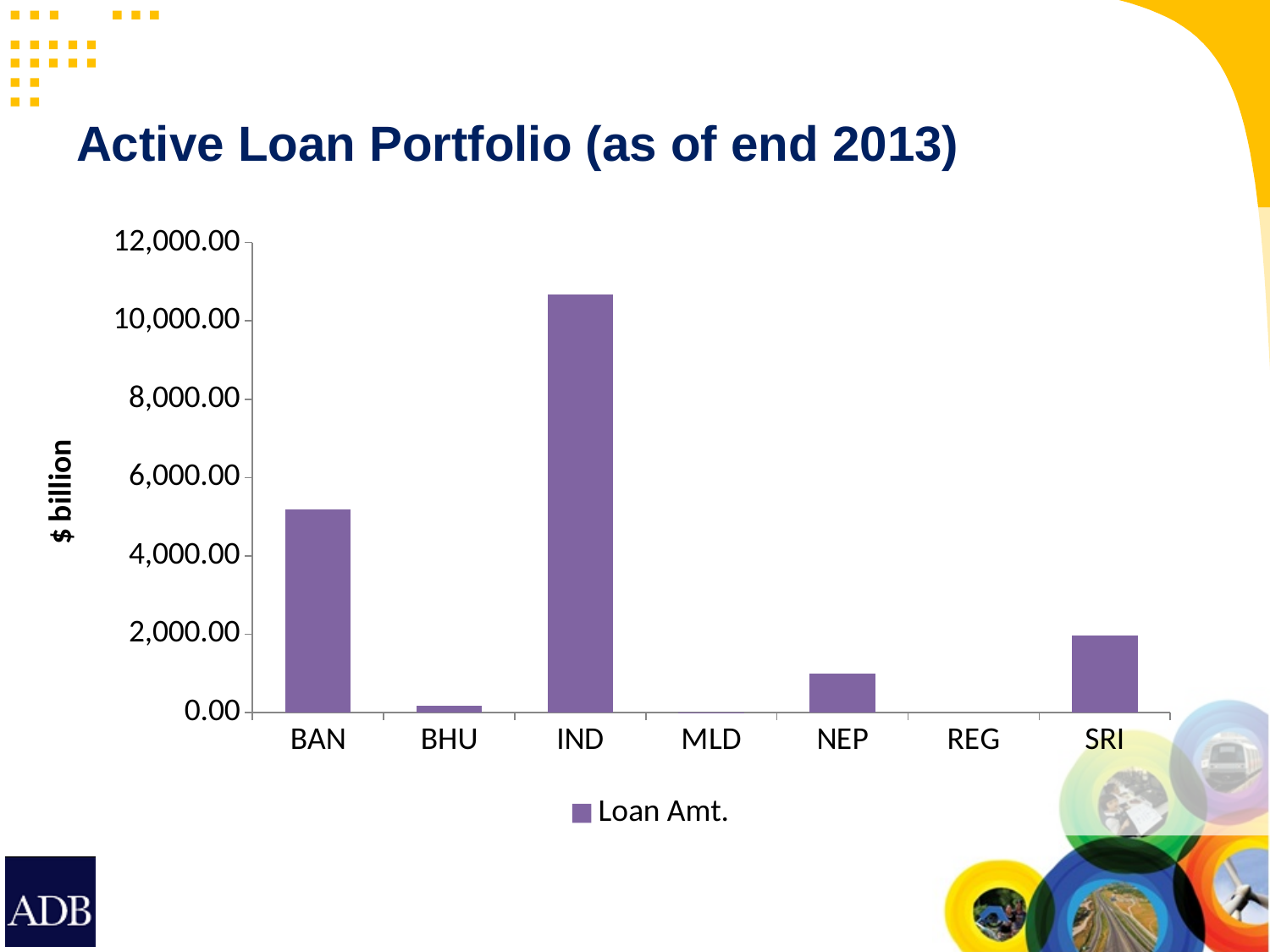
How many series does the chart's legend list? 1 Is the value for SRI greater or less than 4,000.00? less Is the value for IND greater or less than 10,000.00? greater Is the value for BAN greater or less than 4,000.00? greater Which has the larger loan amount, NEP or BHU? NEP What is the series name shown in the chart's legend? Loan Amt. What is the title of the chart's vertical axis? $ billion Which has the larger loan amount, BAN or SRI? BAN How many categories are shown on the x axis of the chart? 7 What kind of chart is shown on the slide? bar chart Which has the larger loan amount, IND or BAN? IND Which category has the highest loan amount? IND